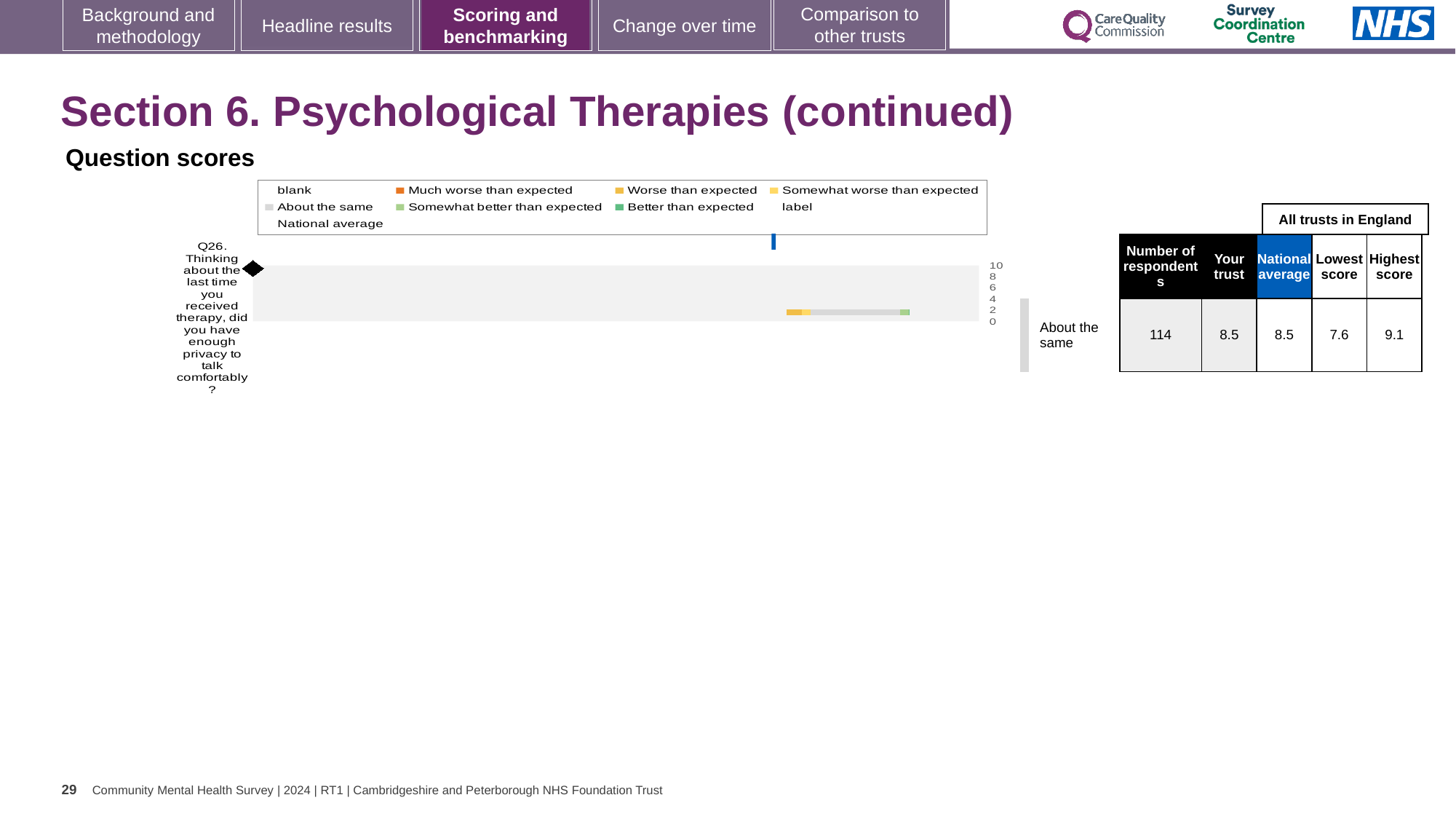
Which question number is plotted in the chart? Q26 What kind of chart is shown under 'Question scores'? bar chart Is the highest score for Q26 greater or less than 8? greater What is the highest score among all trusts in England for Q26? 9.1 What is the difference between the highest score and the lowest score for Q26? 1.5 What is the national average score for Q26? 8.5 What benchmark category label is shown next to the bar for Q26? About the same What is the lowest score among all trusts in England for Q26? 7.6 Is the 'Your trust' score for Q26 higher or lower than the national average? neither, both are 8.5 How many respondents answered Q26? 114 How many survey questions are plotted in the chart? 1 What is the 'Your trust' score for Q26? 8.5